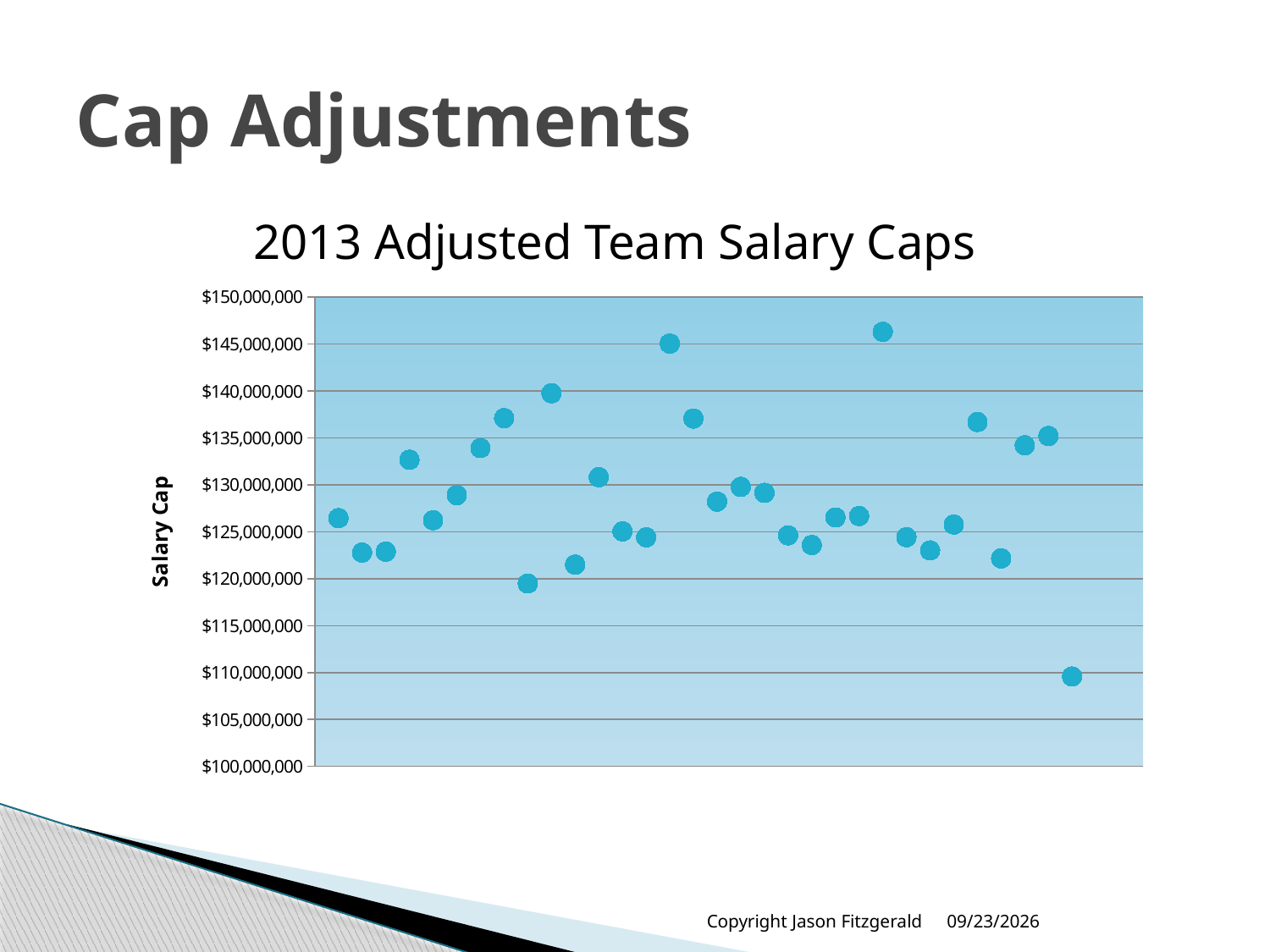
Is the lowest point on the chart greater or less than $105,000,000? greater How many data points are plotted on the chart? 32 Is the highest point on the chart greater or less than $145,000,000? greater What kind of chart is shown on the slide? Scatter chart What is the highest value shown on the vertical axis? $150,000,000 What is the lowest value shown on the vertical axis? $100,000,000 What is the title of the chart? 2013 Adjusted Team Salary Caps How many points on the chart lie above $140,000,000? 2 What is the label on the vertical axis of the chart? Salary Cap How many points on the chart lie below $115,000,000? 1